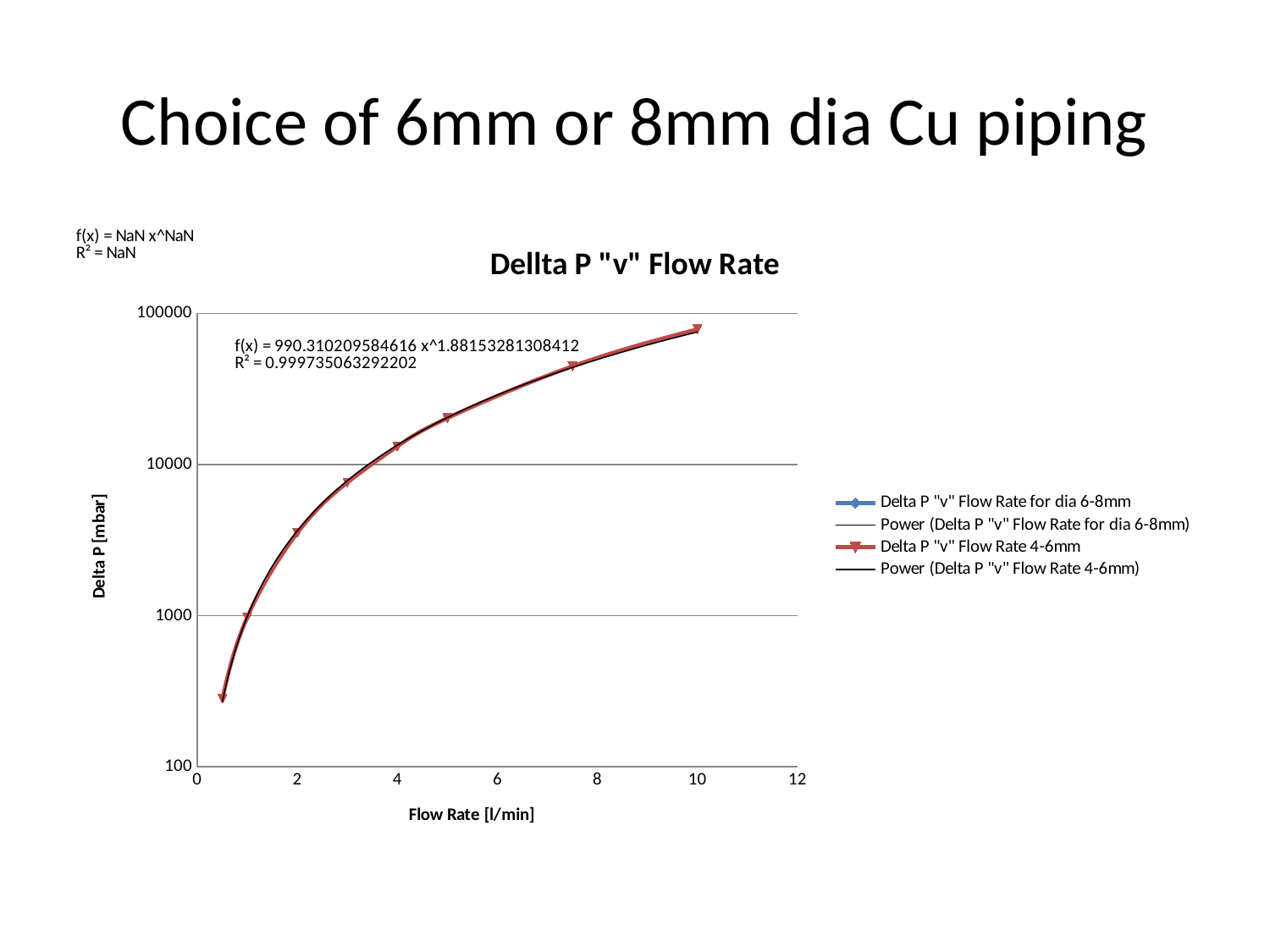
What is the title of the chart? Dellta P "v" Flow Rate How many entries does the chart legend list? 4 Is the Delta P value at a Flow Rate of 0.5 l/min greater or less than 1000? less Does Delta P rise or fall as Flow Rate increases along the x axis? rise At which Flow Rate is the plotted Delta P lowest? 0.5 At which Flow Rate is the plotted Delta P highest? 10 Is the Delta P value at a Flow Rate of 2 l/min greater or less than 1000? greater Is the Delta P value at a Flow Rate of 5 l/min greater or less than 10000? greater How many data points are plotted on the curve? 8 What is the R² value printed inside the plot area for the fitted power trendline? 0.999735063292202 What kind of chart is shown on the slide? line chart